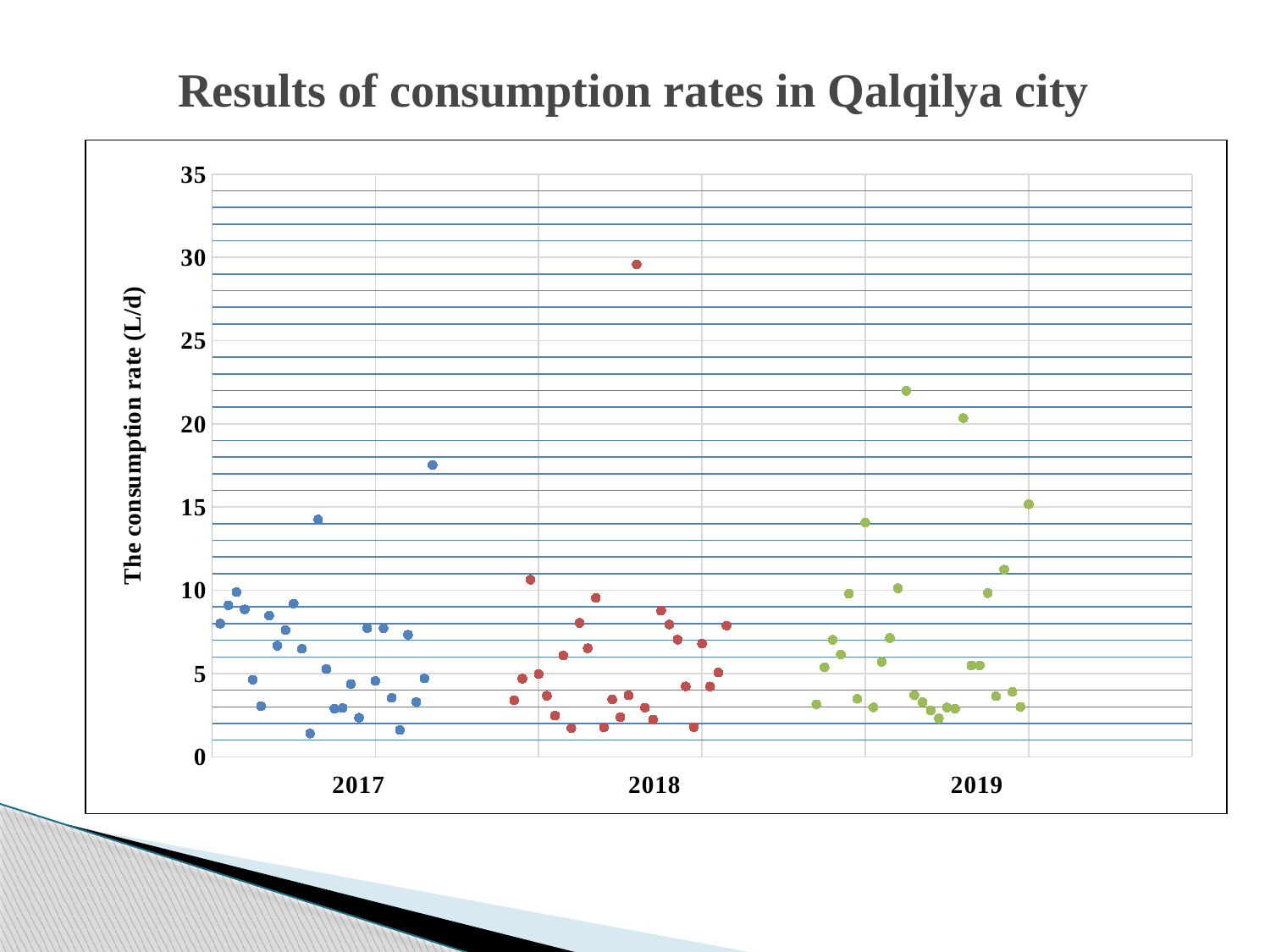
Is the highest plotted point in the 2018 group greater or less than 30? less What kind of chart is shown on the slide? scatter chart What is the title of the chart? Results of consumption rates in Qalqilya city Is the highest plotted point in the 2017 group greater or less than 20? less Which group has the higher maximum point, 2017 or 2019? 2019 What is the label on the vertical axis of the chart? The consumption rate (L/d) Is the highest plotted point in the 2019 group greater or less than 20? greater How many years are labelled along the horizontal axis of the chart? 3 What is the highest value shown on the vertical axis of the chart? 35 Which year's group contains the single highest plotted point on the chart? 2018